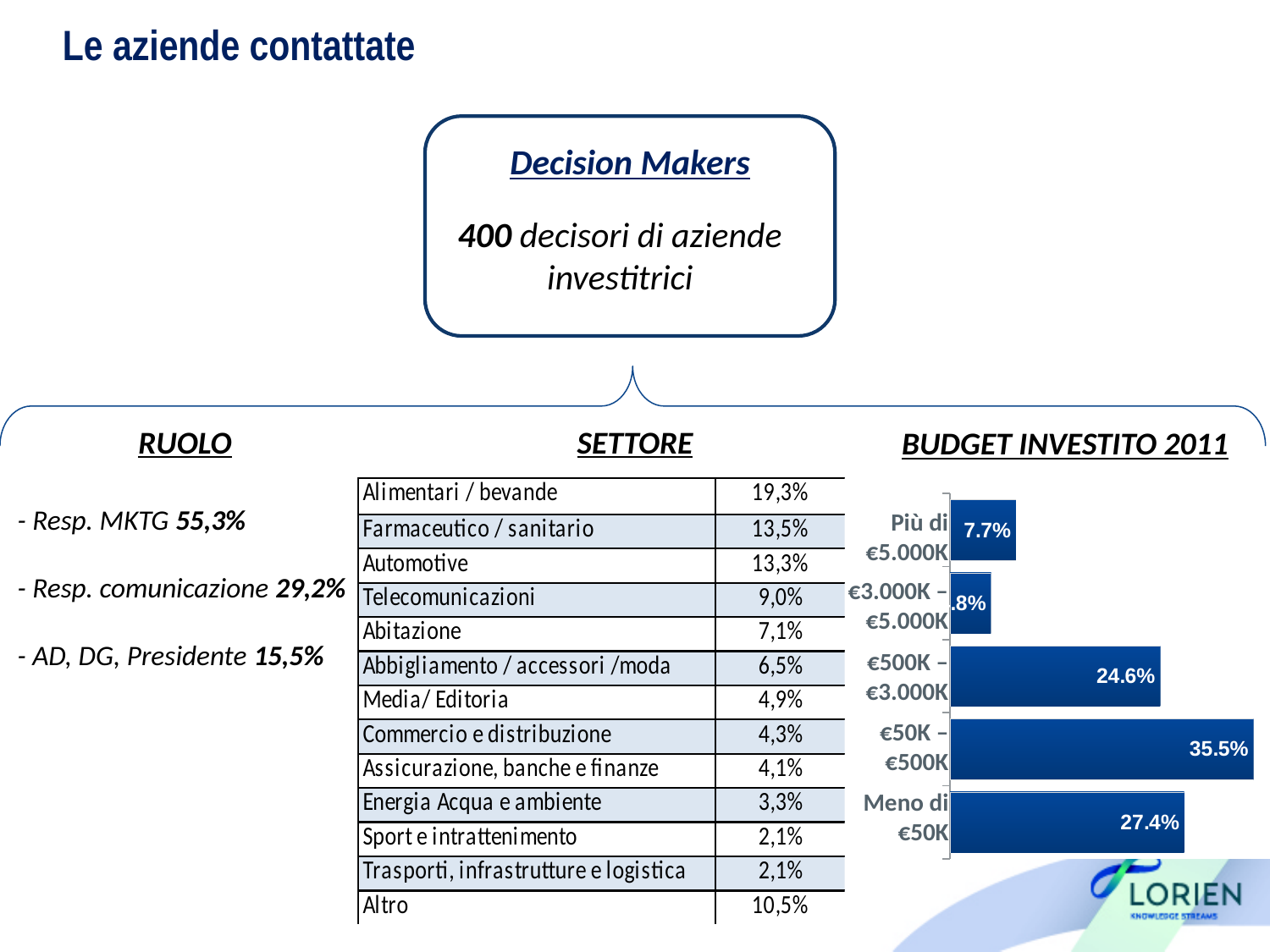
In the BUDGET INVESTITO 2011 chart, which is larger: Meno di €50K or €500K – €3.000K? Meno di €50K What type of chart is shown under the heading BUDGET INVESTITO 2011? bar chart In the BUDGET INVESTITO 2011 chart, what is the value for Più di €5.000K? 7.7% In the BUDGET INVESTITO 2011 chart, how many budget categories are shown? 5 In the BUDGET INVESTITO 2011 chart, what is the difference between the €500K – €3.000K value and the Più di €5.000K value? 16.9% In the BUDGET INVESTITO 2011 chart, what is the value for the €50K – €500K category? 35.5% In the BUDGET INVESTITO 2011 chart, what is the difference between the €50K – €500K value and the Meno di €50K value? 8.1% In the BUDGET INVESTITO 2011 chart, what is the value for the €500K – €3.000K category? 24.6% In the BUDGET INVESTITO 2011 chart, what is the value for Meno di €50K? 27.4% In the BUDGET INVESTITO 2011 chart, which budget category has the lowest value? €3.000K – €5.000K In the BUDGET INVESTITO 2011 chart, which is larger: Più di €5.000K or €500K – €3.000K? €500K – €3.000K In the BUDGET INVESTITO 2011 chart, which budget category has the highest value? €50K – €500K